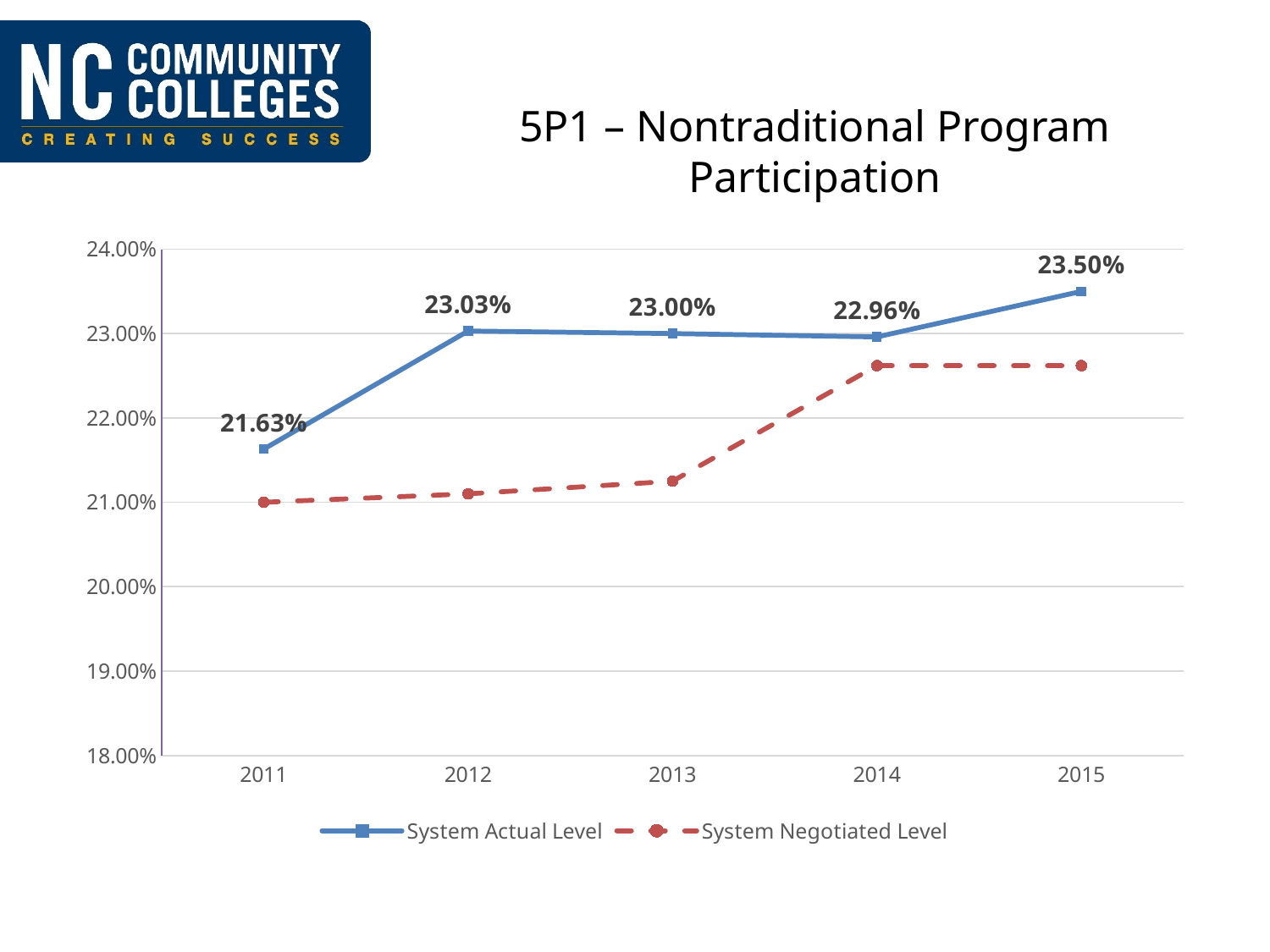
What is the System Actual Level for 2013? 23.00% In which year is the System Actual Level highest? 2015 Is the System Negotiated Level for 2014 greater or less than 22.00%? greater Is the System Negotiated Level for 2012 greater or less than 22.00%? less What is the difference between the System Actual Level in 2015 and in 2011? 1.87% What kind of chart is shown on the slide? line chart What is the System Actual Level for 2015? 23.50% In which year is the System Actual Level lowest? 2011 How many years are shown on the x axis? 5 How many series does the legend list? 2 What is the System Actual Level for 2011? 21.63% Which is larger, the System Actual Level in 2012 or in 2014? 2012